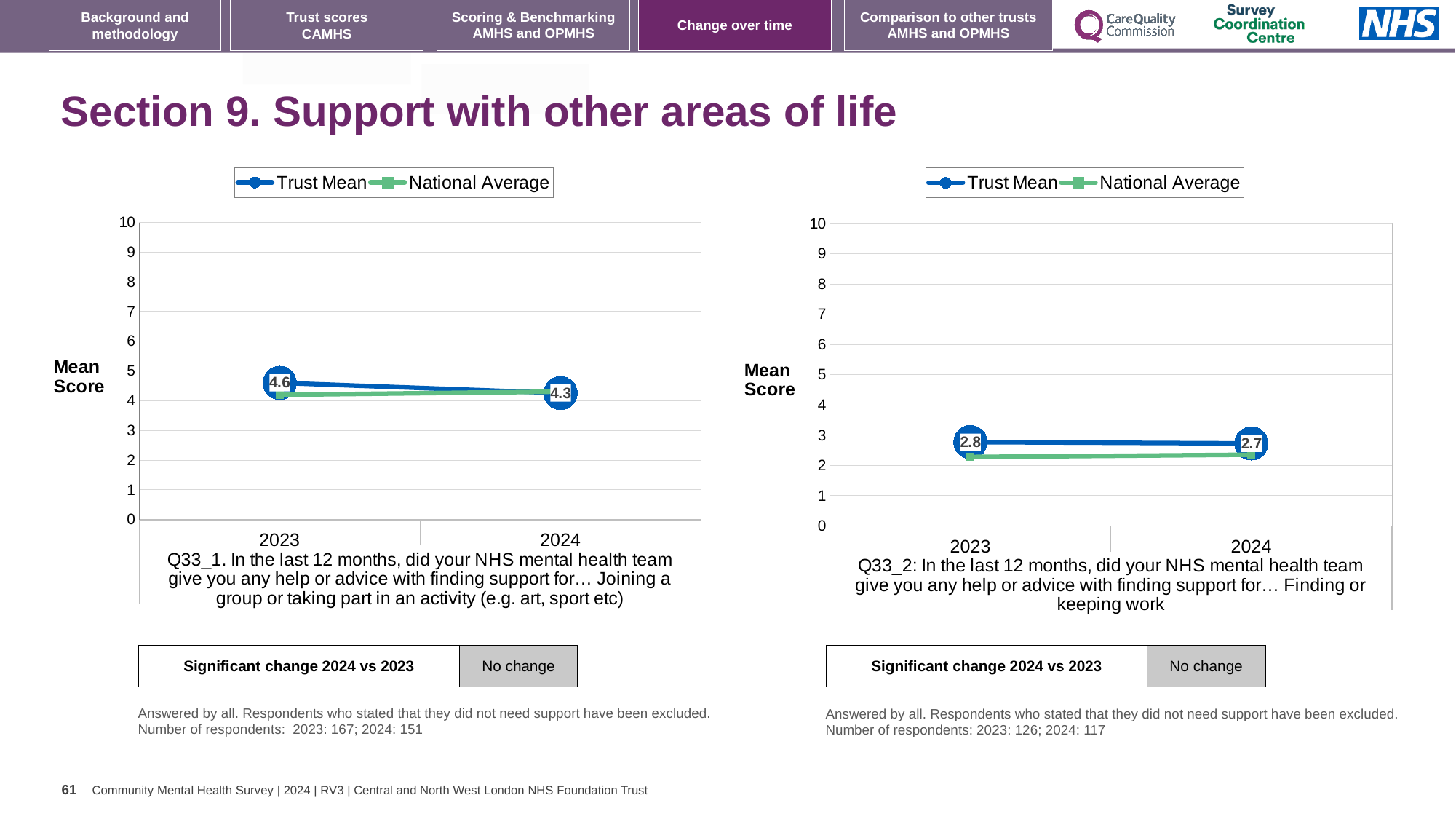
In the right chart (Q33_2), what is the Trust Mean for 2024? 2.7 In the left chart (Q33_1), which year has the higher Trust Mean, 2023 or 2024? 2023 What kind of chart is the left chart (Q33_1)? line chart How many series does the legend of the right chart (Q33_2) list? 2 How many years are plotted on the x axis of the left chart (Q33_1)? 2 In the right chart (Q33_2), is the National Average for 2023 greater or less than 3? less In the left chart (Q33_1), what is the Trust Mean for 2023? 4.6 In the left chart (Q33_1), what is the Trust Mean for 2024? 4.3 In the right chart (Q33_2), what is the Trust Mean for 2023? 2.8 In the right chart (Q33_2), what is the difference between the Trust Mean in 2023 and 2024? 0.1 In the left chart (Q33_1), does the Trust Mean rise or fall from 2023 to 2024? fall In the left chart (Q33_1), by how much did the Trust Mean change from 2023 to 2024? 0.3